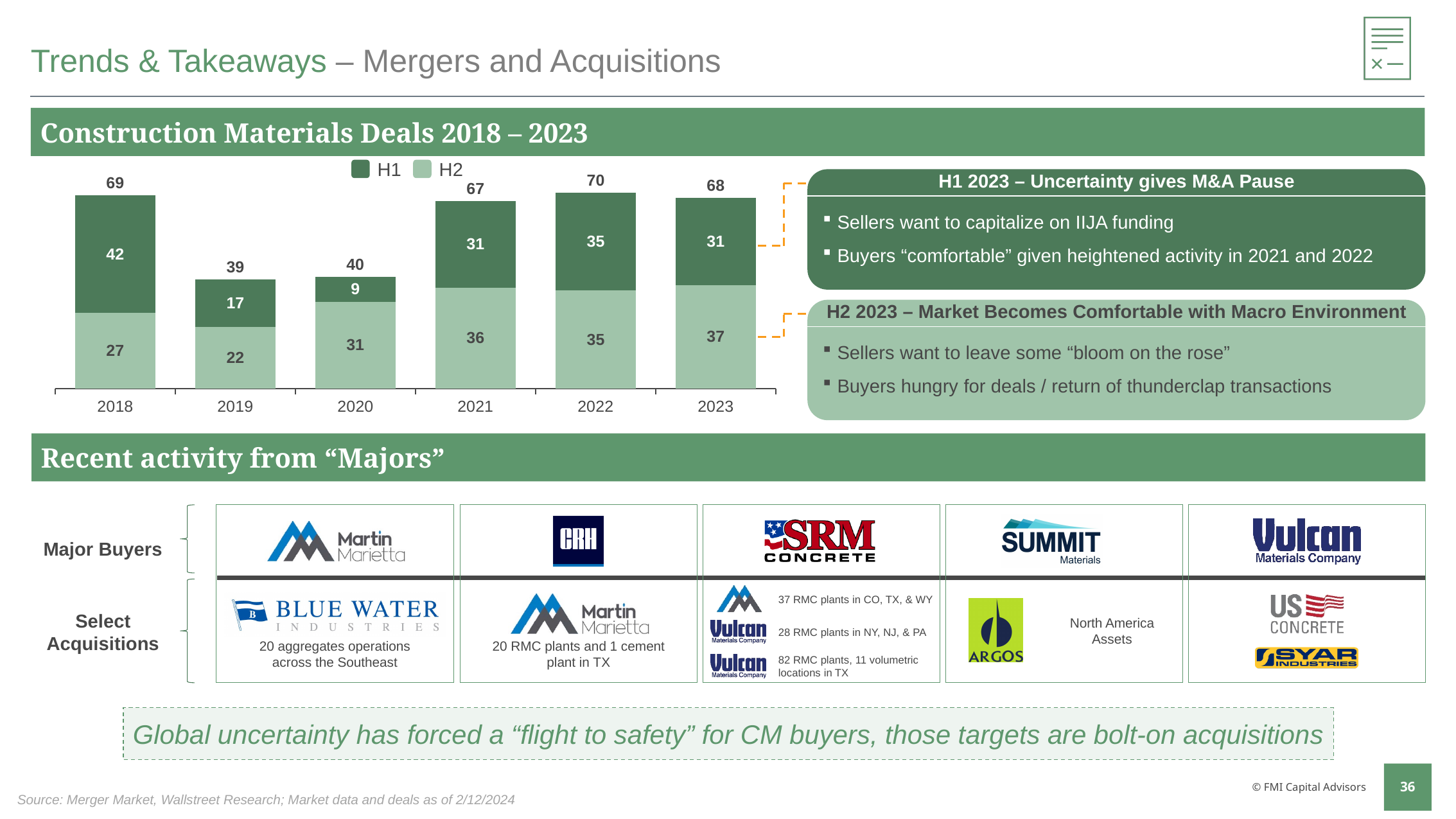
What is the H1 value for 2018 in the Construction Materials Deals chart? 42 What is the difference between the H1 values for 2018 and 2020 in the Construction Materials Deals chart? 33 What is the total number of deals for 2022 in the Construction Materials Deals chart? 70 How many series does the legend of the Construction Materials Deals chart list? 2 What type of chart is used to show Construction Materials Deals 2018 – 2023? Stacked bar chart Which year has the lowest H1 value in the Construction Materials Deals chart? 2020 Which year has the highest total deals in the Construction Materials Deals chart? 2022 How many years are shown on the x axis of the Construction Materials Deals chart? 6 In the Construction Materials Deals chart, is the H2 value for 2021 larger than the H1 value for 2021? Yes, H2 (36) is larger than H1 (31) What is the H2 value for 2023 in the Construction Materials Deals chart? 37 Which year has the lowest total deals in the Construction Materials Deals chart? 2019 Which colour represents H2 in the Construction Materials Deals chart? Light green